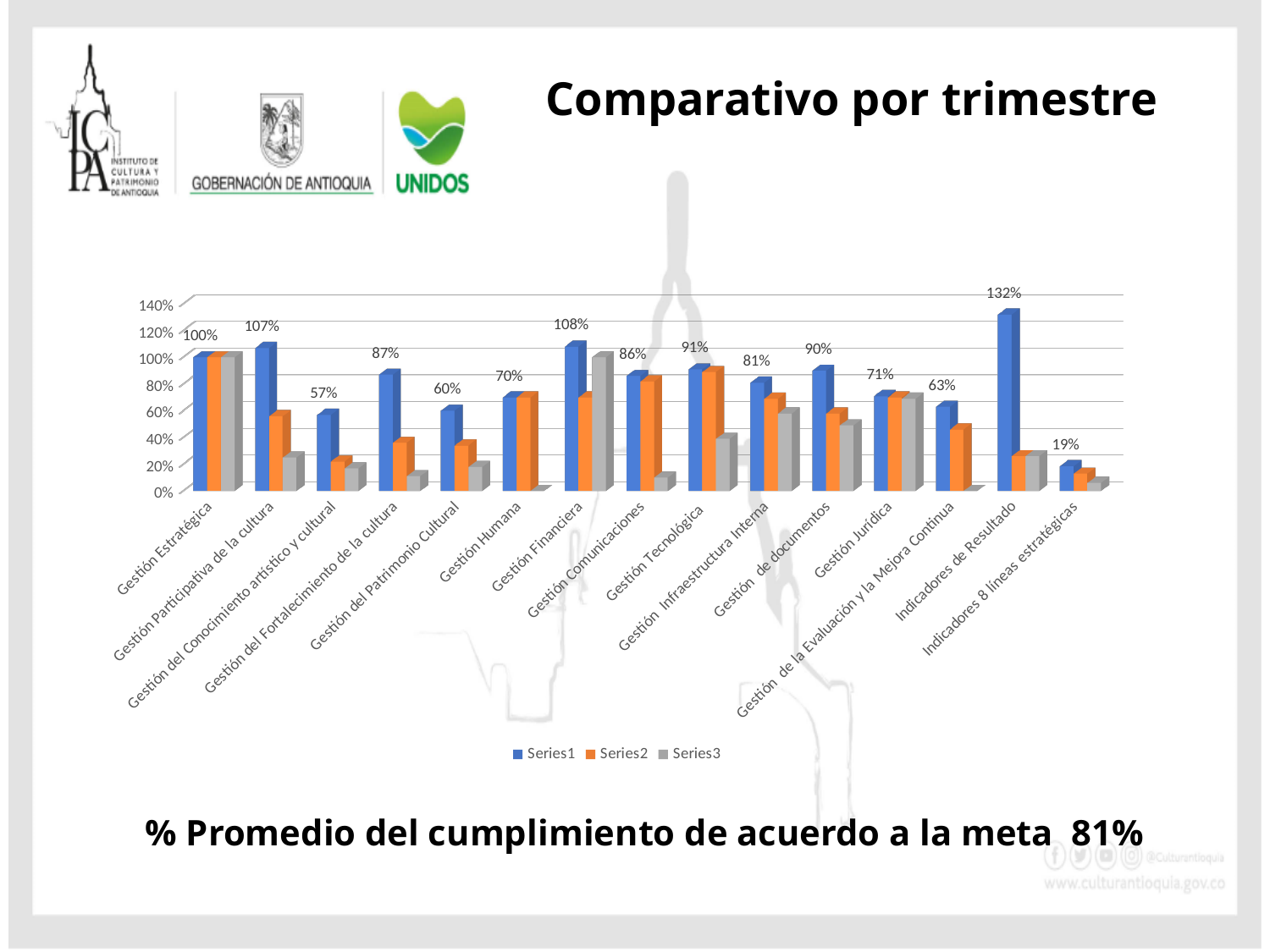
Is the Series2 value for Gestión del Conocimiento artístico y cultural greater or less than 40%? less Is the Series3 value for Gestión Financiera greater or less than 80%? greater Which category has the highest Series1 value? Indicadores de Resultado What is the Series1 value for Gestión del Patrimonio Cultural? 60% What is the Series1 value for Gestión Financiera? 108% How many categories are shown on the x axis of the chart? 15 How many series does the legend list? 3 What is the Series1 value for Gestión Estratégica? 100% What type of chart is shown on the slide? Bar chart Which category has the lowest Series1 value? Indicadores 8 líneas estratégicas Which has a larger Series1 value, Gestión Participativa de la cultura or Gestión Jurídica? Gestión Participativa de la cultura What is the difference between the Series1 values for Indicadores de Resultado and Gestión Tecnológica? 41%